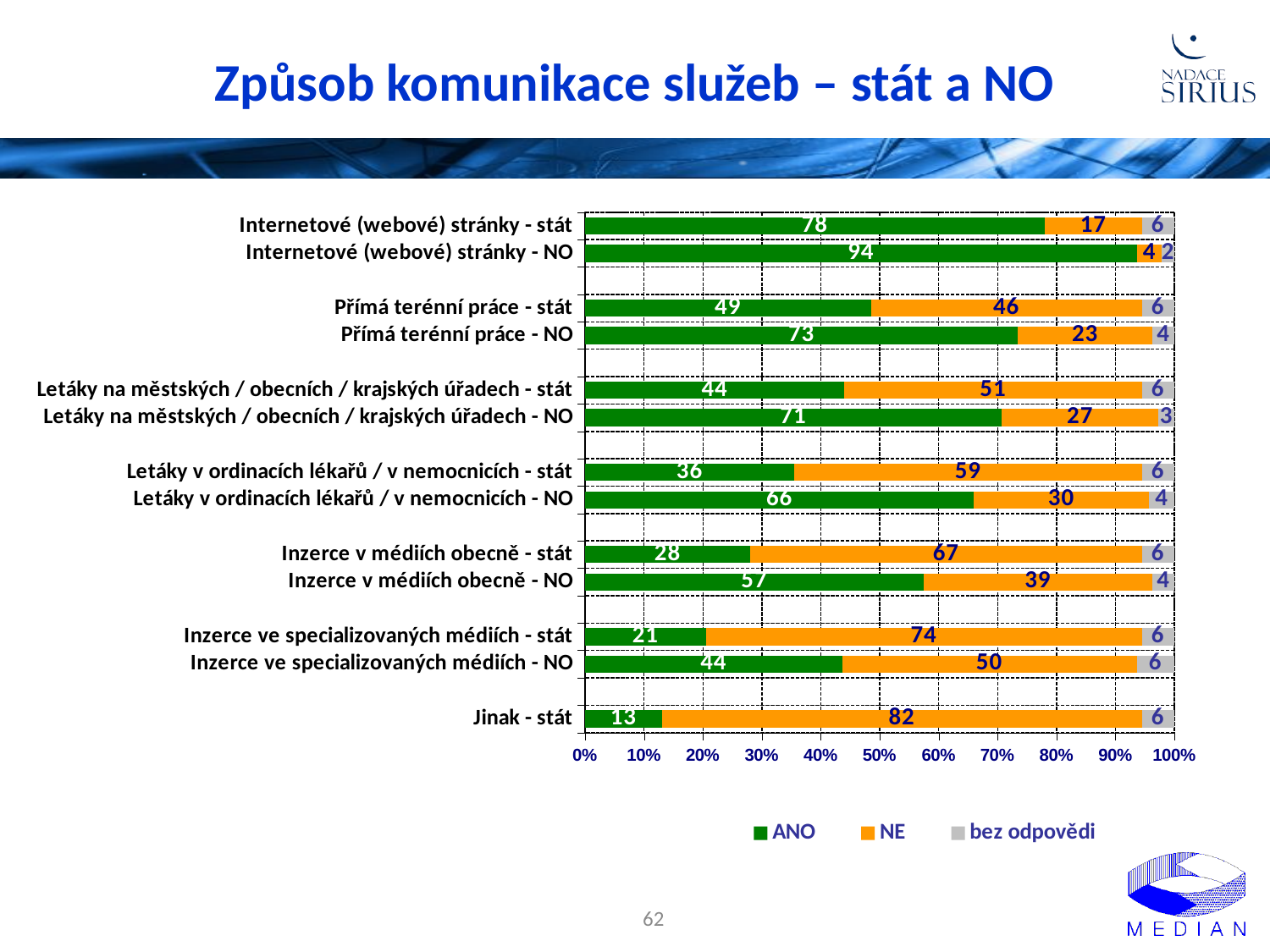
Which category has the highest ANO value? Internetové (webové) stránky - NO What is the "bez odpovědi" value for "Letáky na městských / obecních / krajských úřadech - NO"? 3 How many categories are shown on the chart? 13 What is the total of the stacked bar for "Internetové (webové) stránky - NO"? 100 Which has a larger NE value: "Inzerce v médiích obecně - stát" or "Inzerce v médiích obecně - NO"? Inzerce v médiích obecně - stát What is the ANO value for "Internetové (webové) stránky - stát"? 78 How many series does the legend list? 3 What are the three legend entries of the chart? ANO, NE, bez odpovědi Which category has the lowest ANO value? Jinak - stát What is the NE value for "Jinak - stát"? 82 What kind of chart is shown on the slide? Stacked bar chart What is the difference between the ANO values for "Přímá terénní práce - NO" and "Přímá terénní práce - stát"? 24